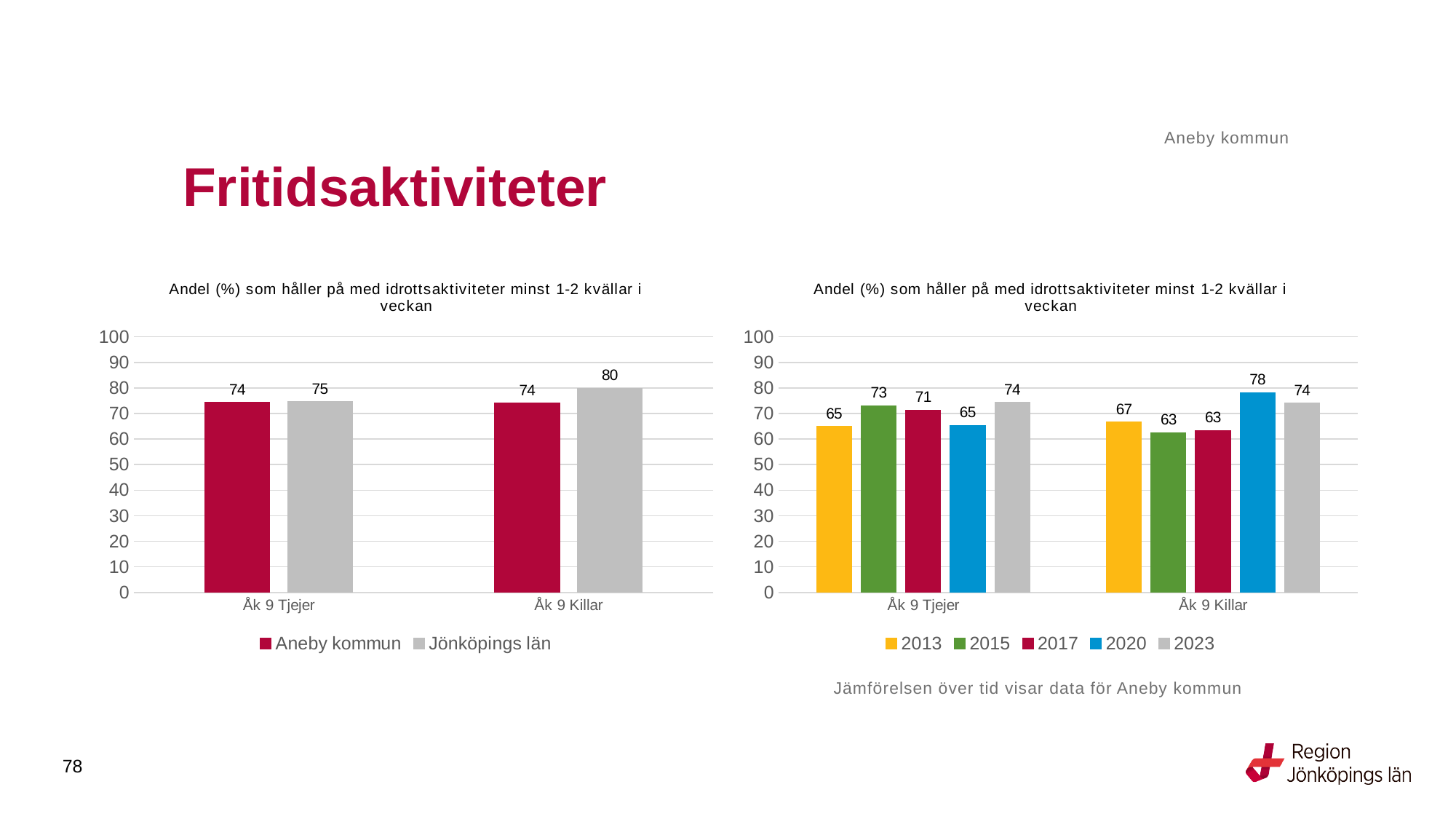
In the right chart, what is the value for 2020 for Åk 9 Killar? 78 In the right chart, what is the value for 2013 for Åk 9 Tjejer? 65 What kind of chart is the left chart? bar chart In the right chart, which year has the highest value for Åk 9 Killar? 2020 In the right chart, which year has the lowest value for Åk 9 Tjejer? 2013 and 2020 (both 65) In the left chart, what is the difference between Jönköpings län and Aneby kommun for Åk 9 Killar? 6 In the left chart, what is the value for Aneby kommun for Åk 9 Killar? 74 In the left chart, how many series does the legend list? 2 In the left chart, what is the value for Jönköpings län for Åk 9 Killar? 80 In the right chart, how many series does the legend list? 5 In the right chart, is the 2015 value for Åk 9 Tjejer larger or smaller than the 2017 value for Åk 9 Tjejer? larger In the right chart, what is the difference between the 2023 and 2013 values for Åk 9 Tjejer? 9